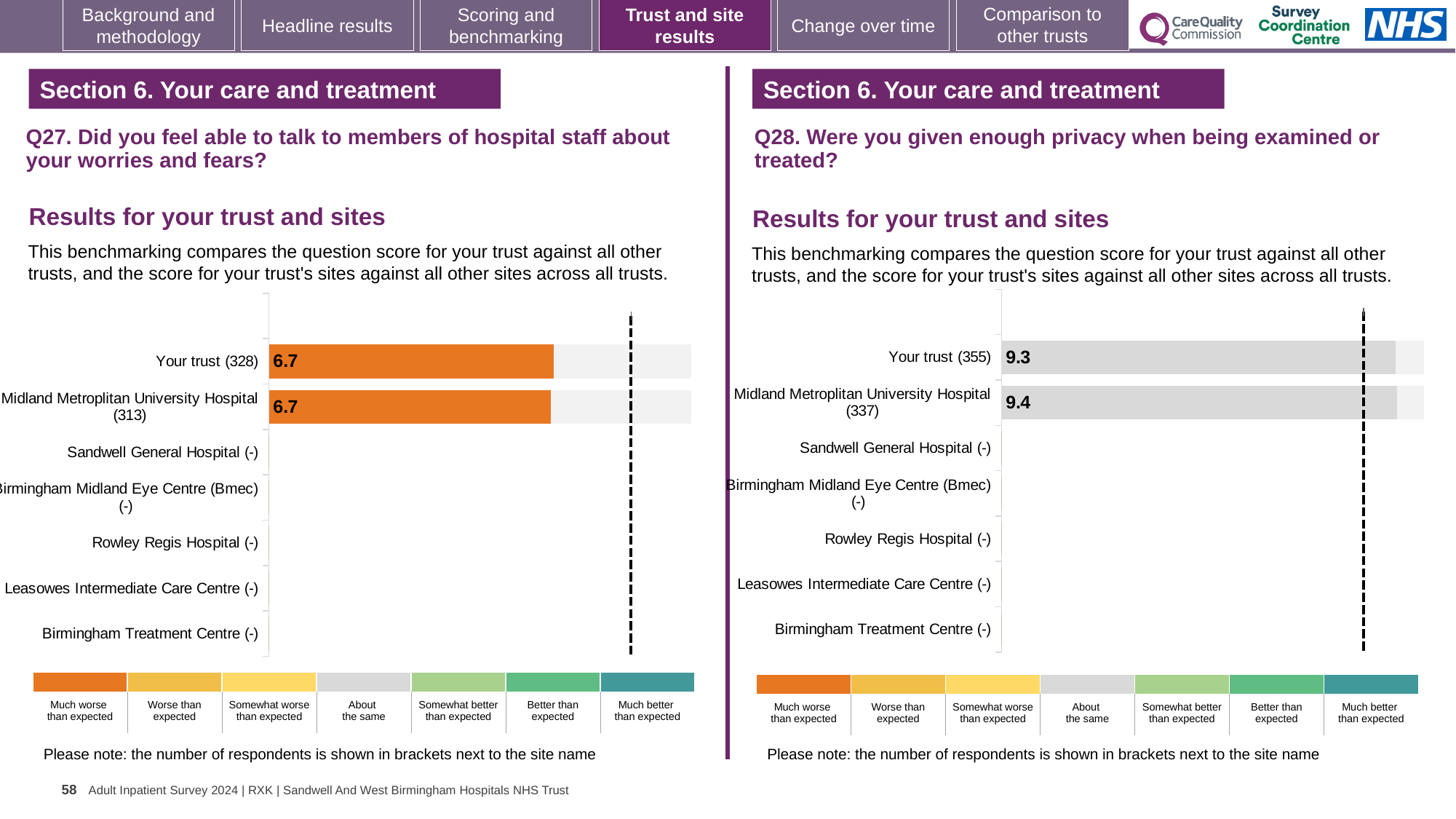
On the Q27 chart, what is the score for Your trust (328)? 6.7 On the Q28 chart, which has the higher score: Your trust or Midland Metropolitan University Hospital? Midland Metropolitan University Hospital On the Q27 chart, what is the difference between the Your trust score and the Midland Metropolitan University Hospital score? 0.0 How many site categories are listed on the Q27 chart? 7 On the Q28 chart, what is the score for Your trust (355)? 9.3 On the Q28 chart, what is the difference between the Midland Metropolitan University Hospital score and the Your trust score? 0.1 On the Q28 chart, how many sites have a score plotted? 2 On the Q27 chart, what is the score for Midland Metropolitan University Hospital (313)? 6.7 What type of chart is used for the Q27 results? Bar chart On the Q28 chart, which benchmark category does the grey bar colour represent according to the legend? About the same On the Q27 chart, which benchmark category does the orange bar colour represent according to the legend? Much worse than expected On the Q28 chart, what is the score for Midland Metropolitan University Hospital (337)? 9.4